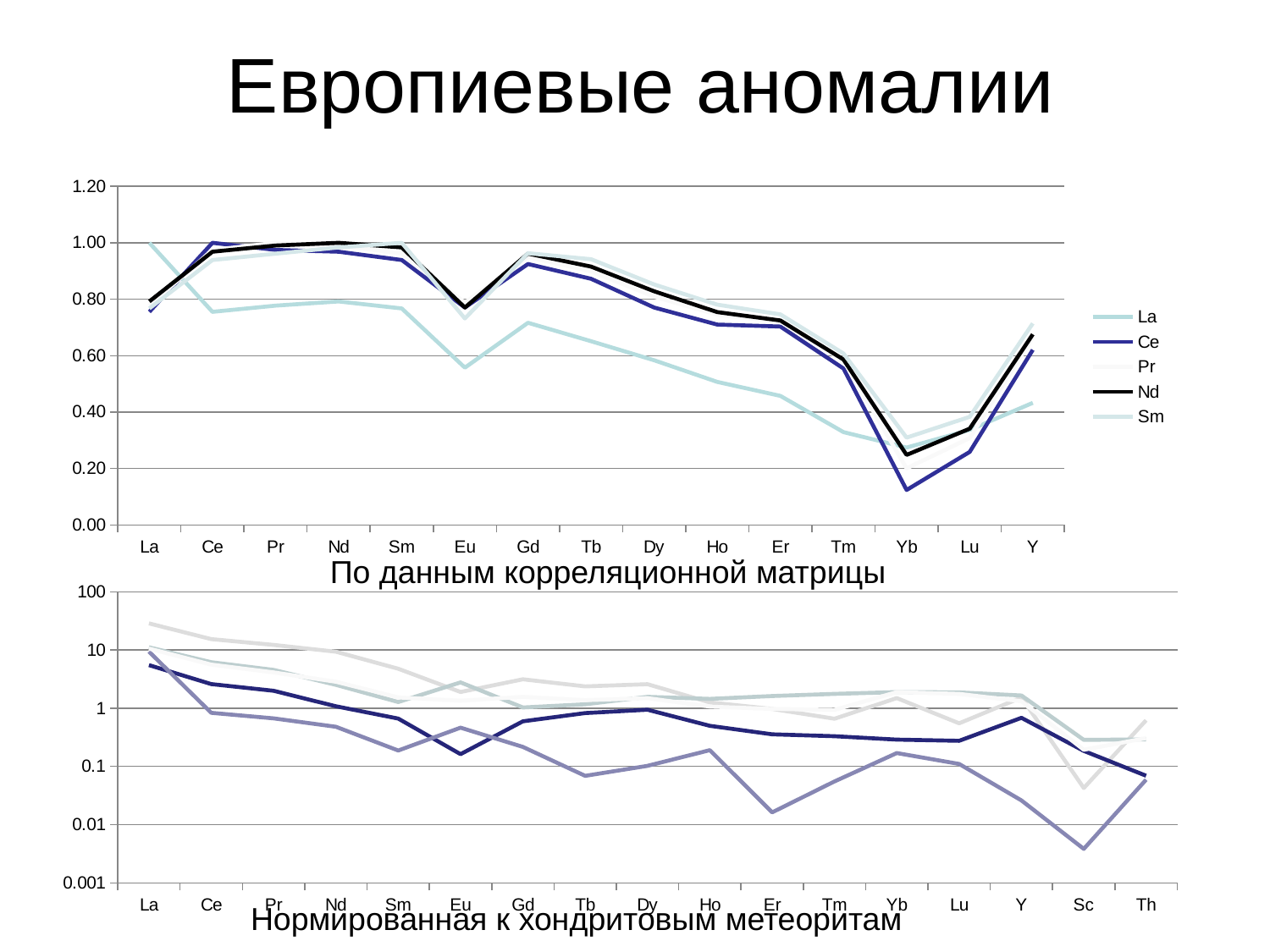
In the top chart 'По данным корреляционной матрицы', does the Nd series rise or fall from Yb to Y? rise In the top chart 'По данным корреляционной матрицы', is the value of the Ce series at Yb greater or less than 0.20? less In the top chart 'По данным корреляционной матрицы', is the value of the Nd series at Y greater or less than 0.60? greater What kind of chart is the top chart, 'По данным корреляционной матрицы'? line chart How many categories are shown on the x axis of the bottom chart 'Нормированная к хондритовым метеоритам'? 17 In the top chart 'По данным корреляционной матрицы', does the Nd series rise or fall from Tm to Yb? fall In the bottom chart 'Нормированная к хондритовым метеоритам', is the value of the dark blue line at Th greater or less than 0.1? less How many series does the legend of the top chart 'По данным корреляционной матрицы' list? 5 Which series are listed in the legend of the top chart 'По данным корреляционной матрицы'? La, Ce, Pr, Nd, Sm How many categories are shown on the x axis of the top chart 'По данным корреляционной матрицы'? 15